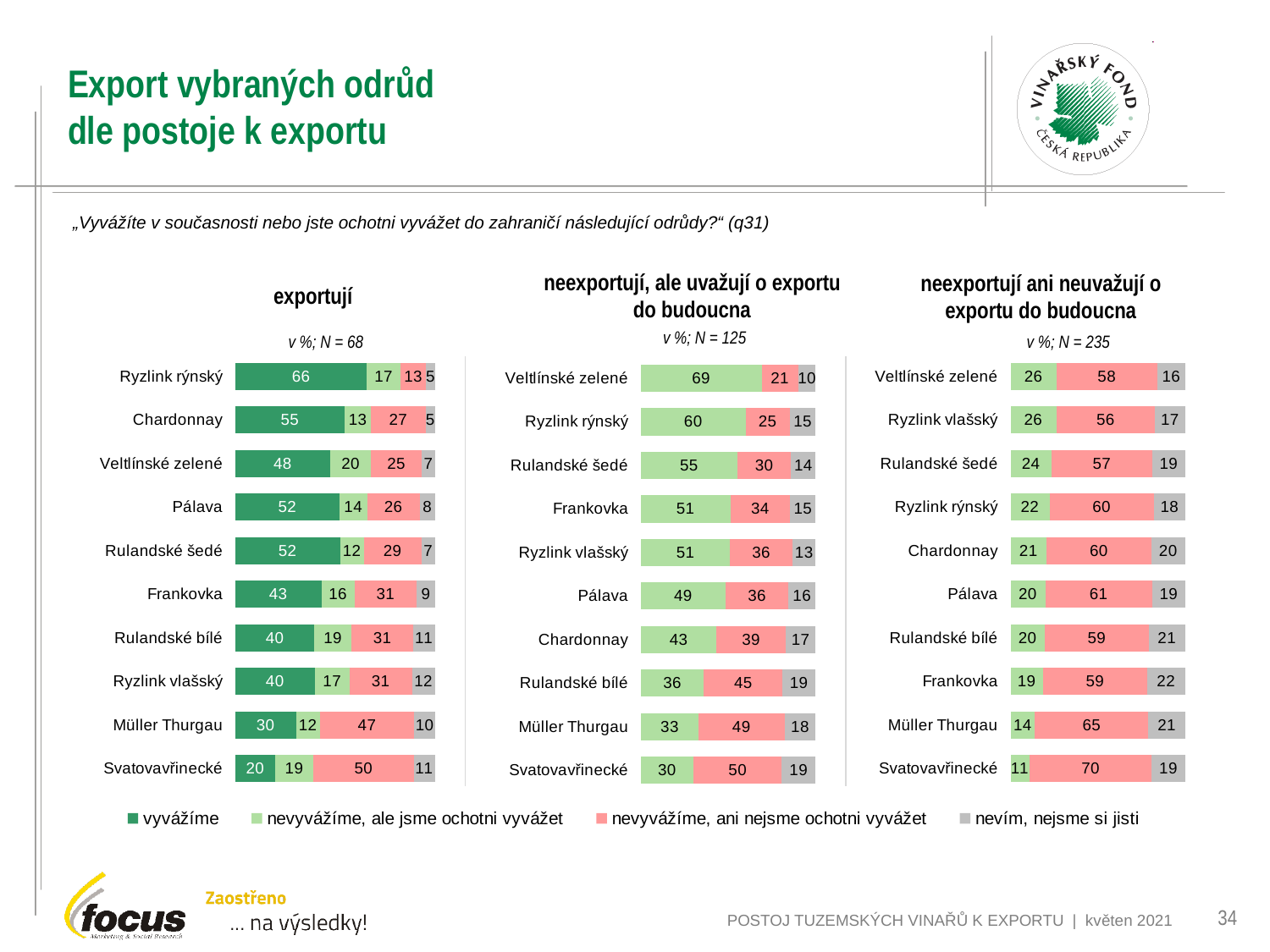
In the "neexportují ani neuvažují o exportu do budoucna" chart, what is the difference between the "nevyvážíme, ani nejsme ochotni vyvážet" values for Müller Thurgau and Veltlínské zelené? 7 How many entries does the shared legend at the bottom of the slide list? 4 In the "neexportují, ale uvažují o exportu do budoucna" chart, which variety has the highest "nevyvážíme, ani nejsme ochotni vyvážet" value? Svatovavřinecké What type of chart is used for the "exportují" chart? Stacked bar chart In the "exportují" chart, what is the difference between the "vyvážíme" values for Chardonnay and Müller Thurgau? 25 In the "exportují" chart, which variety has the lowest "vyvážíme" value? Svatovavřinecké In the "neexportují ani neuvažují o exportu do budoucna" chart, what is the "nevím, nejsme si jisti" value for Frankovka? 22 In the "neexportují, ale uvažují o exportu do budoucna" chart, is the "nevyvážíme, ale jsme ochotni vyvážet" value larger for Frankovka or for Chardonnay? Frankovka How many varieties are listed in the "exportují" chart? 10 In the "neexportují ani neuvažují o exportu do budoucna" chart, what is the "nevyvážíme, ani nejsme ochotni vyvážet" value for Svatovavřinecké? 70 In the "exportují" chart, what is the value of the "vyvážíme" segment for Ryzlink rýnský? 66 In the "neexportují, ale uvažují o exportu do budoucna" chart, what is the "nevyvážíme, ale jsme ochotni vyvážet" value for Veltlínské zelené? 69